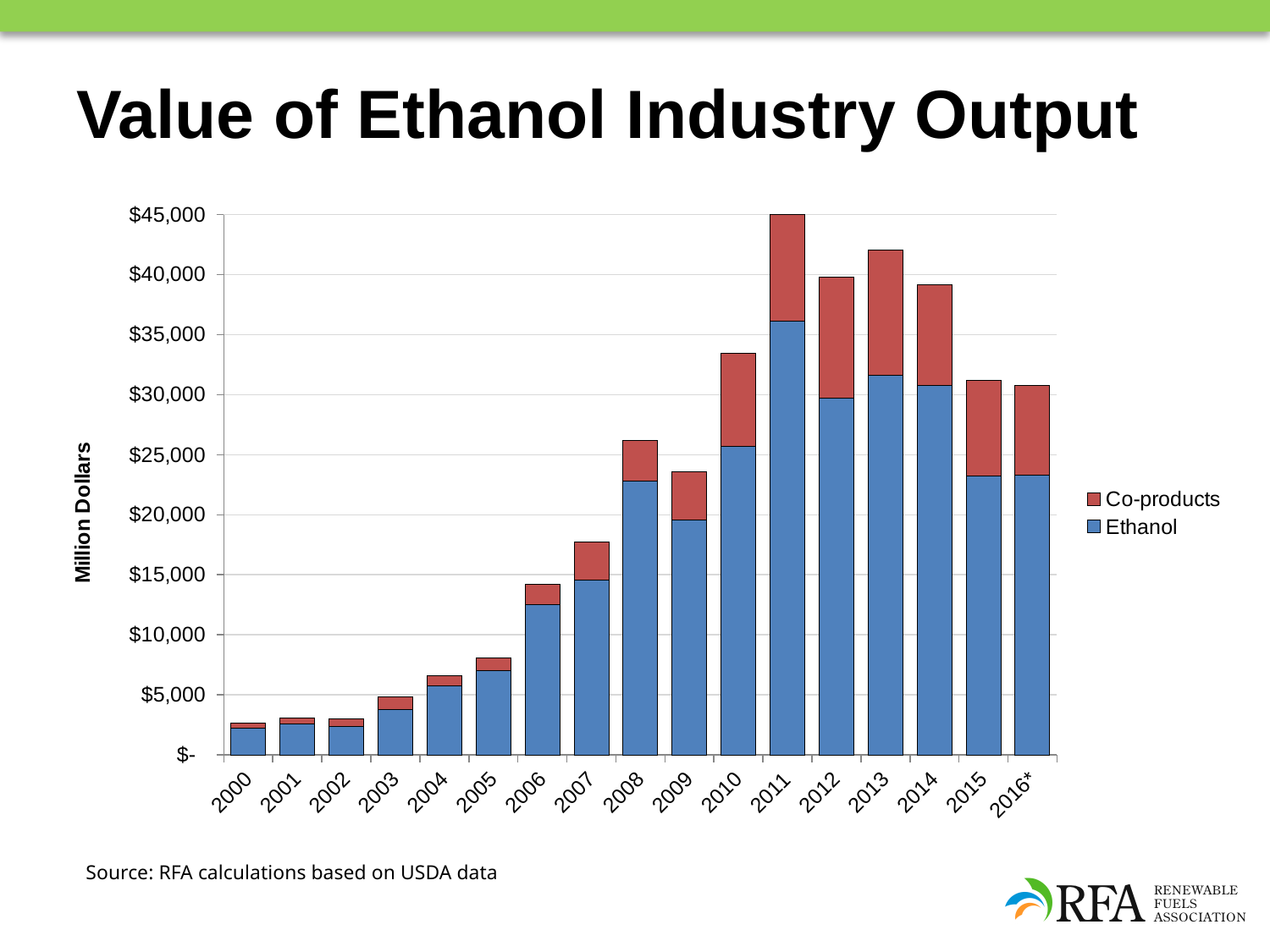
What is the label of the y axis? Million Dollars Which year has the highest total value of ethanol industry output? 2011 Is the total value for 2005 greater or less than $10,000? less Is the total value for 2010 greater or less than $30,000? greater Is the Ethanol value for 2016* greater or less than $25,000? less Which year has the lowest total value of ethanol industry output? 2000 What kind of chart is shown on the slide? Stacked bar chart Which year has a larger total value, 2012 or 2013? 2013 How many years are shown along the x axis? 17 Do the total values rise or fall from 2000 to 2011? rise How many series does the legend list? 2